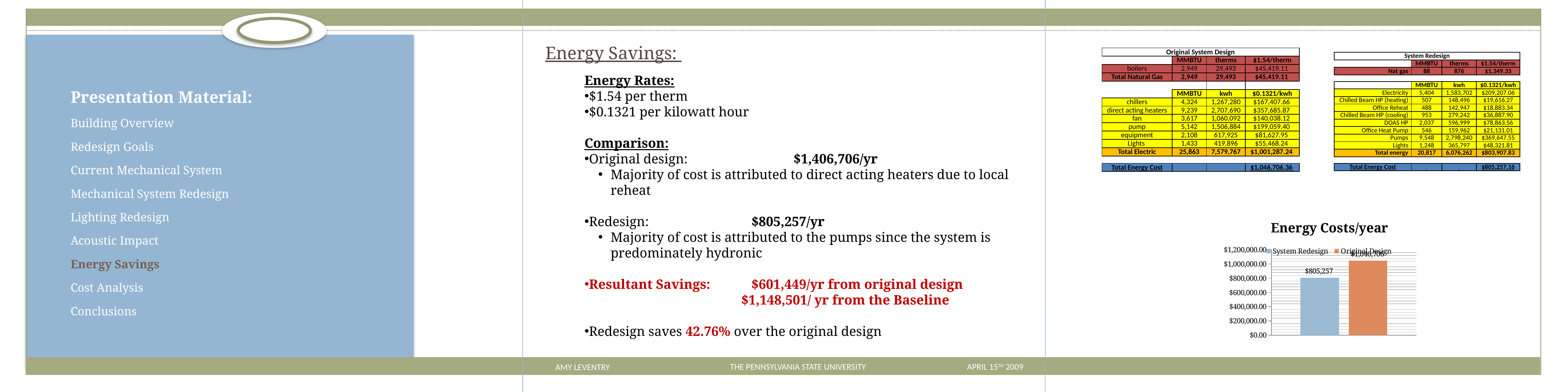
In the "Energy Costs/year" chart, is the value for Original Design greater or less than $800,000.00? greater What kind of chart is the "Energy Costs/year" chart? Bar chart In the "Energy Costs/year" chart, what colour is the System Redesign bar? Blue In the "Energy Costs/year" chart, which bar is the lowest? System Redesign In the "Energy Costs/year" chart, what is the value shown for System Redesign? $805,257 In the "Energy Costs/year" chart, is the value for System Redesign greater or less than $1,000,000.00? less How many bars are plotted in the "Energy Costs/year" chart? 2 What is the title of the bar chart on the right side of the slide? Energy Costs/year In the "Energy Costs/year" chart, is the value for System Redesign greater or less than $600,000.00? greater In the "Energy Costs/year" chart, which bar is the highest? Original Design How many entries does the legend of the "Energy Costs/year" chart list? 2 In the "Energy Costs/year" chart, which is larger: System Redesign or Original Design? Original Design